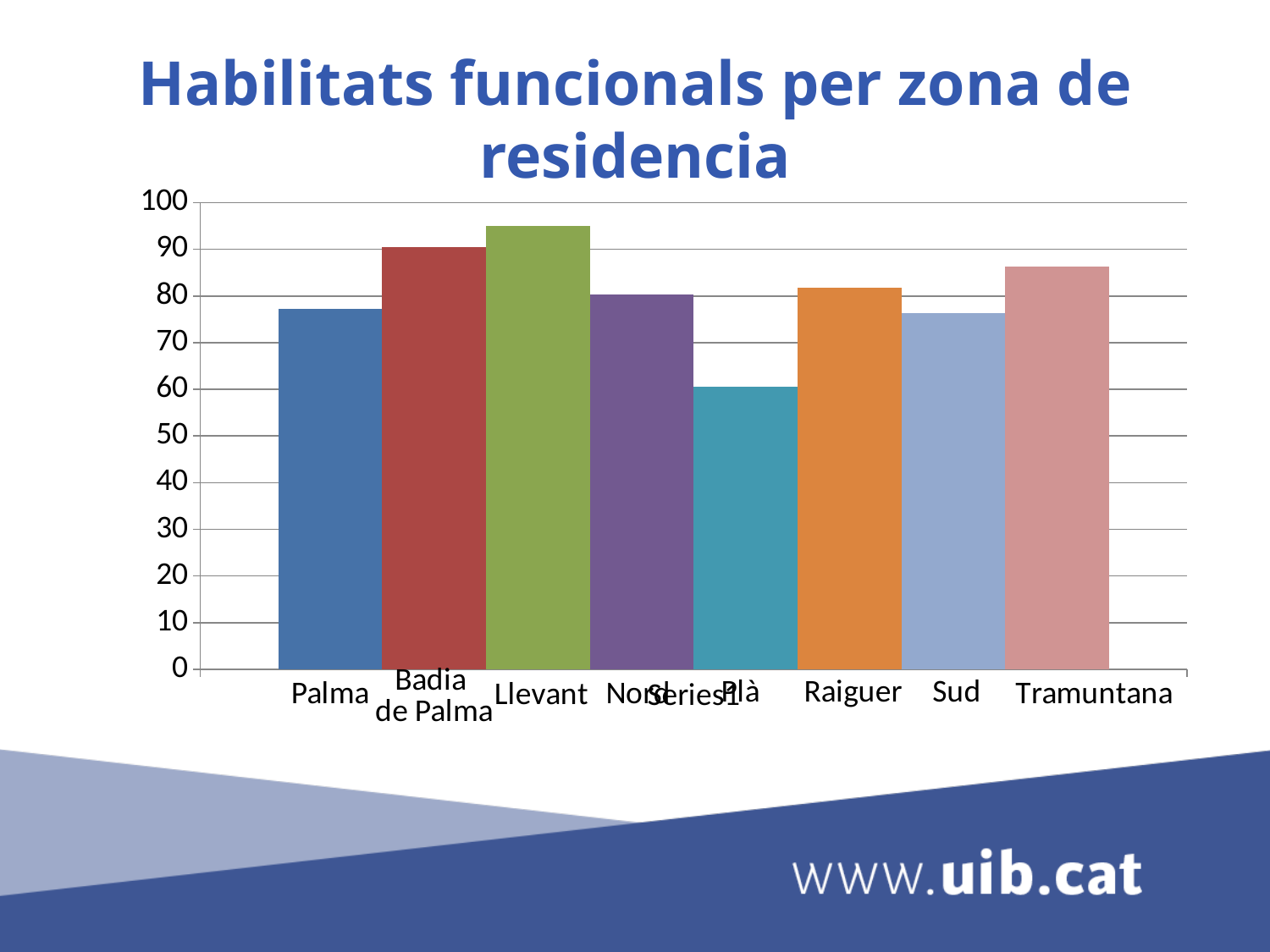
Is the value for Llevant greater or less than 90? greater Is the value for Plà greater or less than 70? less Which zone has the lowest value in the chart? Plà Which zone has the highest value in the chart? Llevant What kind of chart is shown on the slide? bar chart What series name is shown in the chart's legend? Series1 Is the value for Raiguer greater or less than 70? greater How many zones (categories) are plotted in the chart? 8 Which has a larger value, Tramuntana or Sud? Tramuntana Which has a larger value, Badia de Palma or Palma? Badia de Palma What is the title of the chart on the slide? Habilitats funcionals per zona de residencia